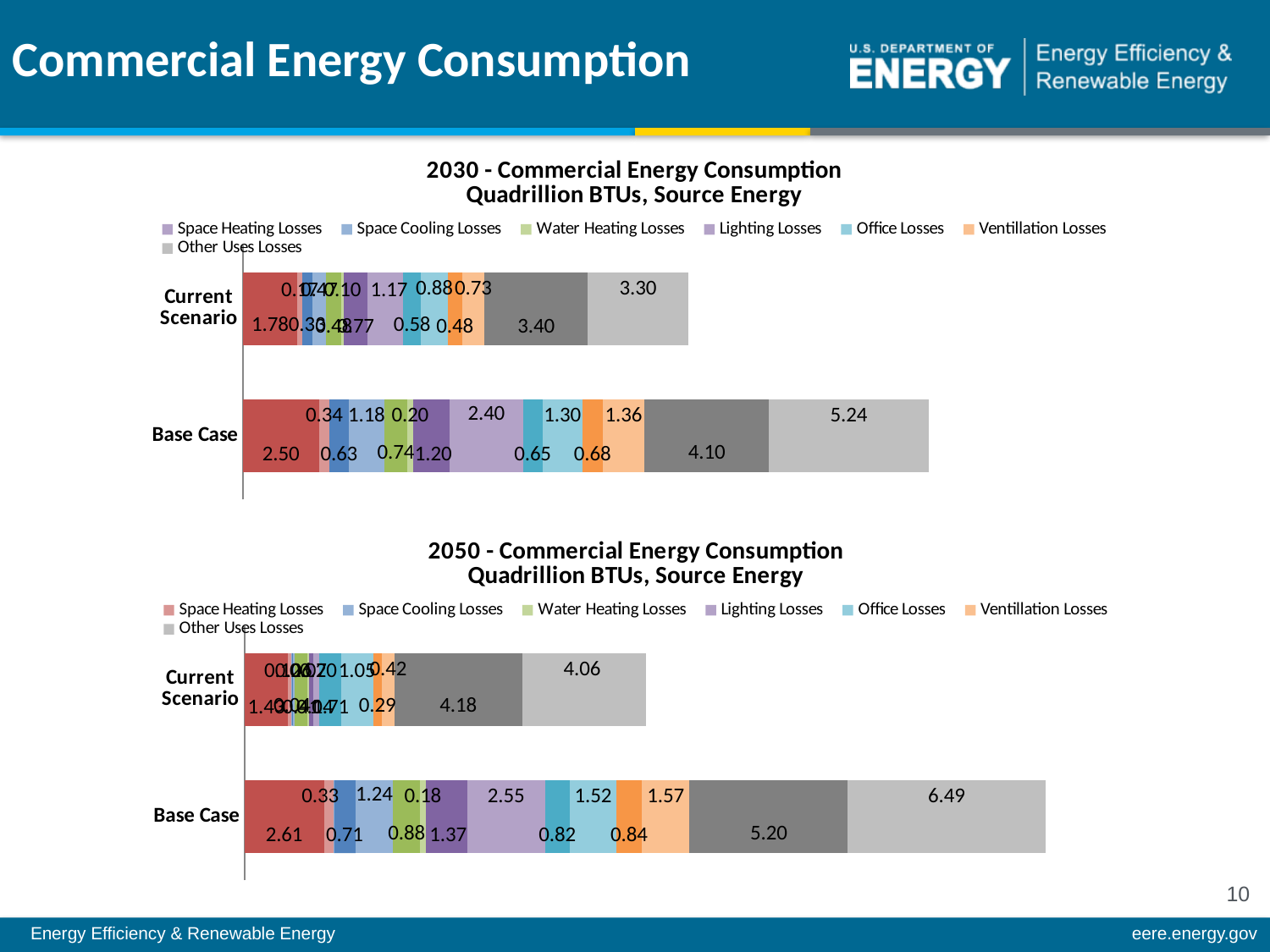
In the 2030 - Commercial Energy Consumption chart, what is the value of the leftmost segment of the Base Case bar? 2.50 In the 2050 - Commercial Energy Consumption chart, what is the value of the leftmost segment of the Base Case bar? 2.61 How many series does the legend of the 2030 - Commercial Energy Consumption chart list? 7 What unit is given in the subtitle of the 2030 - Commercial Energy Consumption chart? Quadrillion BTUs, Source Energy What kind of chart is the 2030 - Commercial Energy Consumption chart? Stacked bar chart What is the difference between the largest Base Case segment in the 2050 chart (6.49) and the largest Base Case segment in the 2030 chart (5.24)? 1.25 In the 2030 - Commercial Energy Consumption chart, what is the value of the largest segment in the Base Case bar? 5.24 In the 2050 - Commercial Energy Consumption chart, which bar is longer overall, Current Scenario or Base Case? Base Case In the 2050 - Commercial Energy Consumption chart, what is the value of the largest segment in the Current Scenario bar? 4.18 In the 2030 - Commercial Energy Consumption chart, what is the value of the largest segment in the Current Scenario bar? 3.40 How many categories (bars) does the 2050 - Commercial Energy Consumption chart show? 2 In the 2050 - Commercial Energy Consumption chart, what is the value of the largest segment in the Base Case bar? 6.49